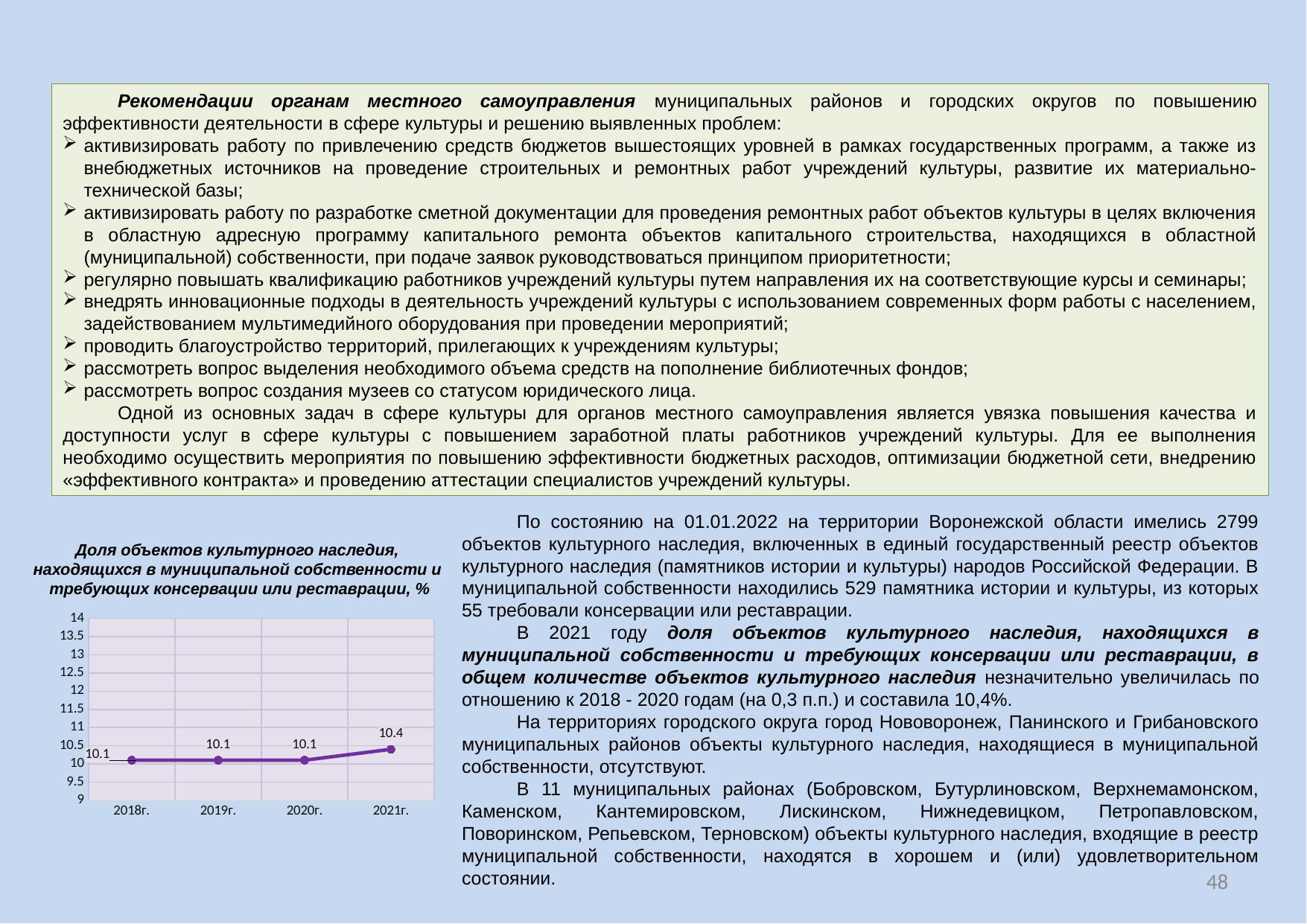
Do the values rise or fall from 2020г. to 2021г.? rise How many years are plotted on the chart? 4 What is the value for 2020г. on the chart? 10.1 Which is larger, the value for 2021г. or the value for 2020г.? 2021г. What is the difference between the values for 2021г. and 2018г.? 0.3 Which year has the highest value on the chart? 2021г. Is the value for 2019г. greater or less than 10? greater What kind of chart is shown on the slide? line chart Is the value for 2021г. greater or less than 11? less What is the title of the chart? Доля объектов культурного наследия, находящихся в муниципальной собственности и требующих консервации или реставрации, % What is the value for 2018г. on the chart? 10.1 What is the value for 2021г. on the chart? 10.4